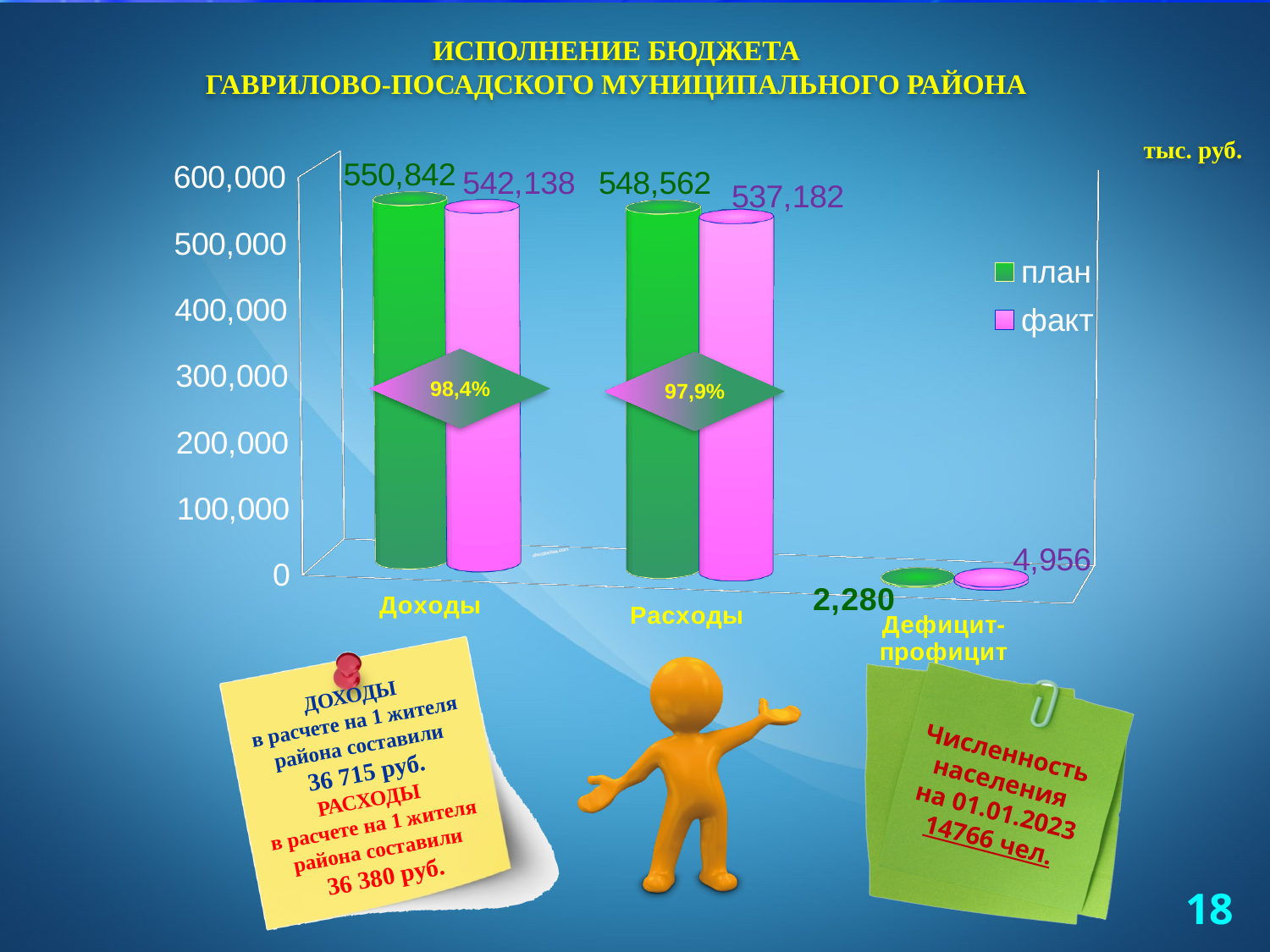
What is the план value for Дефицит-профицит? 2,280 Which category has the lowest факт value? Дефицит-профицит What is the факт value for Расходы? 537,182 Which is larger for Доходы, the план value or the факт value? план What kind of chart is shown on the slide? bar chart What is the факт value for Дефицит-профицит? 4,956 What is the план value for Доходы? 550,842 How many series does the legend list? 2 What is the факт value for Доходы? 542,138 What is the difference between the план and факт values for Расходы? 11,380 How many categories are shown on the x axis? 3 What is the план value for Расходы? 548,562